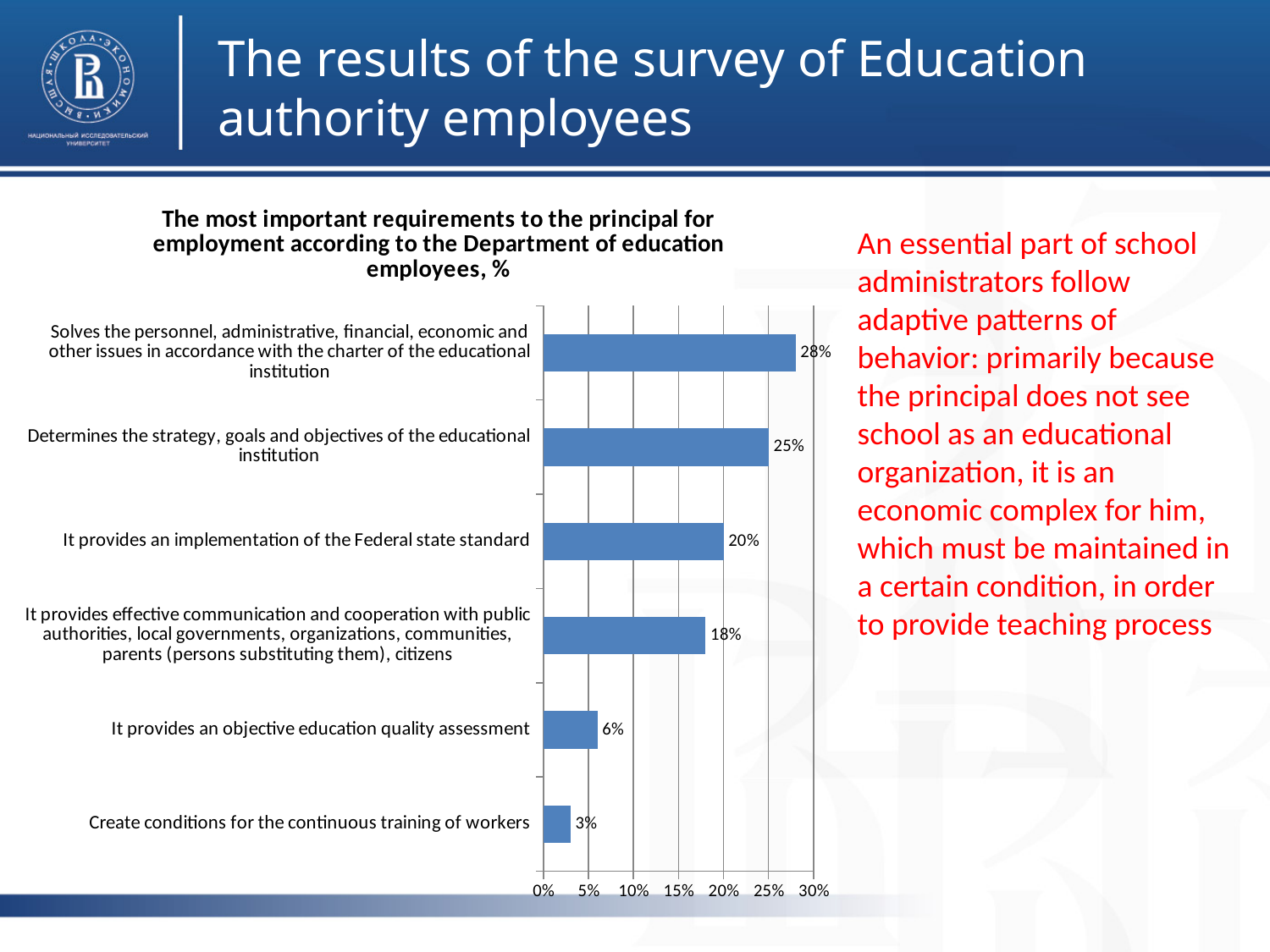
Which category has the highest value? Solves the personnel, administrative, financial, economic and other issues in accordance with the charter of the educational institution What kind of chart is shown on the slide? bar chart What is the difference between the highest and lowest values in the chart? 25% Is the value for "Determines the strategy, goals and objectives of the educational institution" greater or less than 20%? greater How many categories are shown in the chart? 6 What is the value for "It provides an implementation of the Federal state standard"? 20% Which category has the lowest value? Create conditions for the continuous training of workers What is the value for "It provides an objective education quality assessment"? 6% What is the title of the chart? The most important requirements to the principal for employment according to the Department of education employees, % What is the difference between the value for "Determines the strategy, goals and objectives of the educational institution" and the value for "It provides an implementation of the Federal state standard"? 5% Which is larger: the value for "It provides effective communication and cooperation with public authorities, local governments, organizations, communities, parents (persons substituting them), citizens" or the value for "It provides an objective education quality assessment"? It provides effective communication and cooperation with public authorities, local governments, organizations, communities, parents (persons substituting them), citizens What is the value for "Create conditions for the continuous training of workers"? 3%